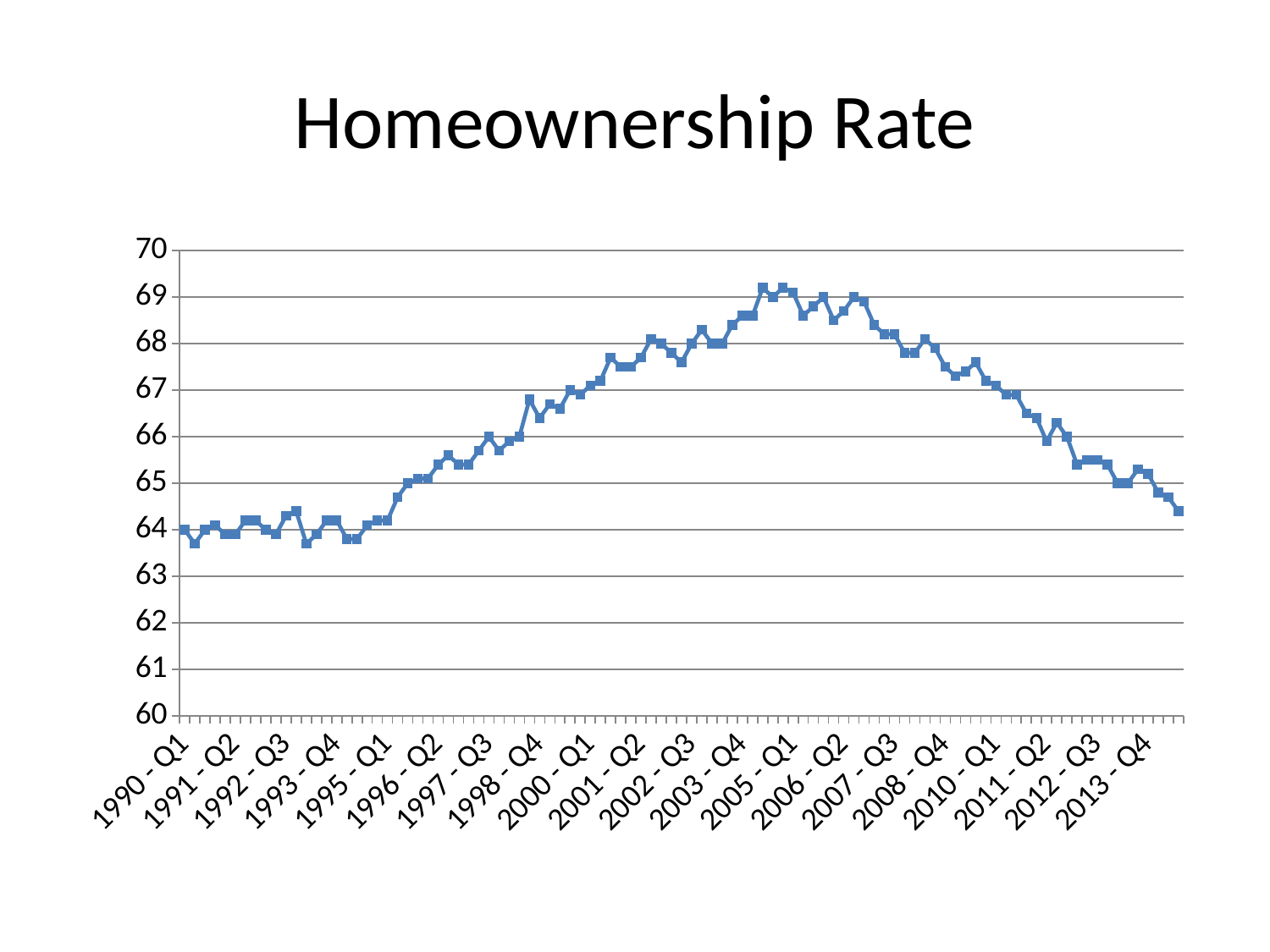
Is the value for 2001 - Q2 greater or less than 67? greater Does the homeownership rate rise or fall between 2006 - Q2 and 2013 - Q4? fall Is the value for 1998 - Q4 greater or less than 66? greater Is the value for 2003 - Q4 greater or less than 68? greater What kind of chart is shown on the slide? line chart Which is larger, the value for 2005 - Q1 or the value for 1990 - Q1? 2005 - Q1 Does the homeownership rate rise or fall between 1995 - Q1 and 2005 - Q1? rise What is the title of the chart? Homeownership Rate What is the range of the vertical axis on the chart? 60 to 70